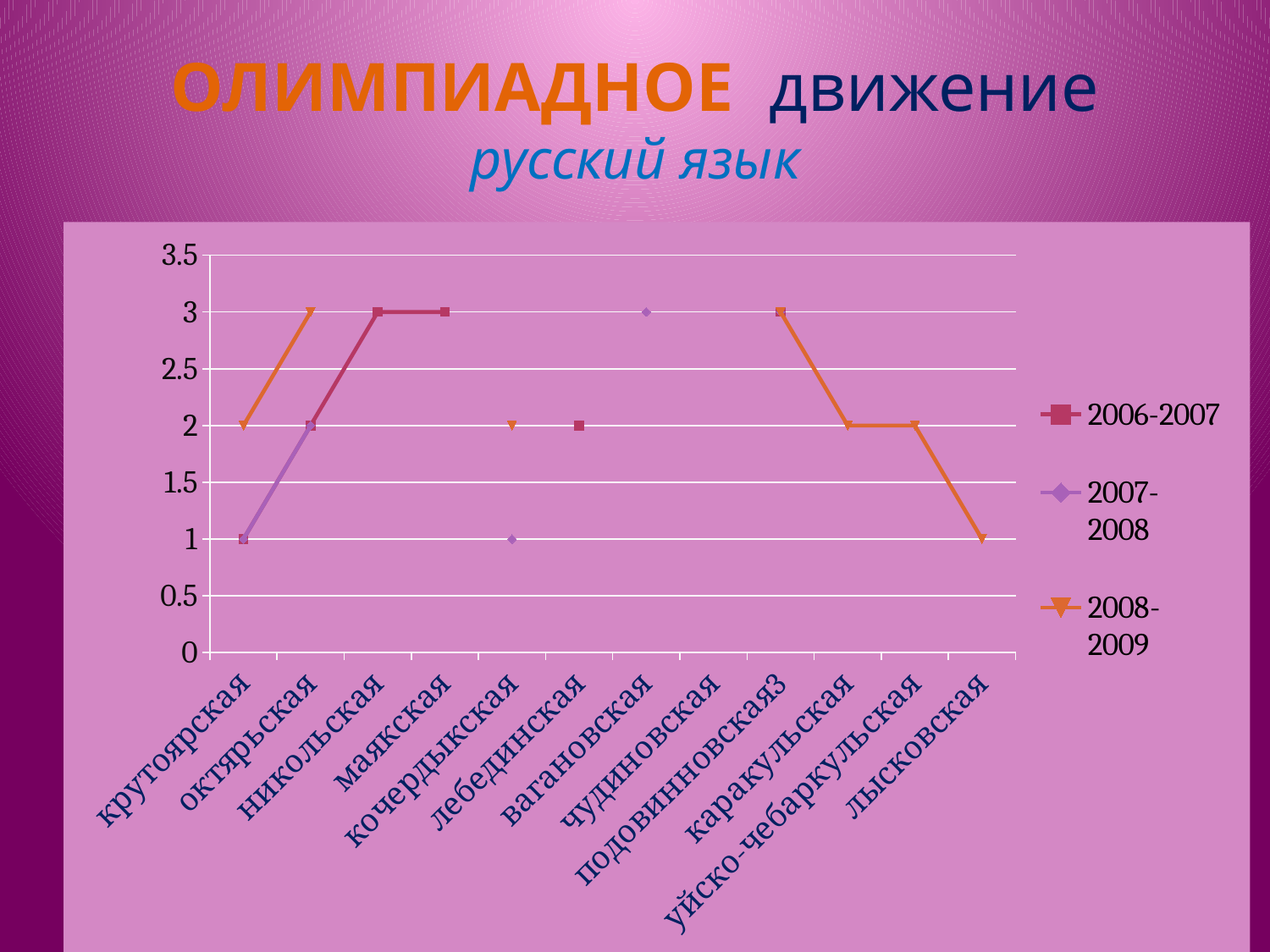
In the 2008-2009 series, do the values rise or fall from подовинновская to лысковская? fall How many series does the legend list? 3 What is the value for лысковская in the 2008-2009 series? 1 In the 2008-2009 series, what is the difference between the values for октярьская and лысковская? 2 What is the value for октярьская in the 2008-2009 series? 3 What are the three entries listed in the legend? 2006-2007, 2007-2008, 2008-2009 What is the value for вагановская in the 2007-2008 series? 3 For крутоярская, which series has the larger value, 2006-2007 or 2008-2009? 2008-2009 What is the value for никольская in the 2006-2007 series? 3 What is the value for кочердыкская in the 2007-2008 series? 1 How many categories are shown along the x axis? 12 What kind of chart is shown on the slide? line chart